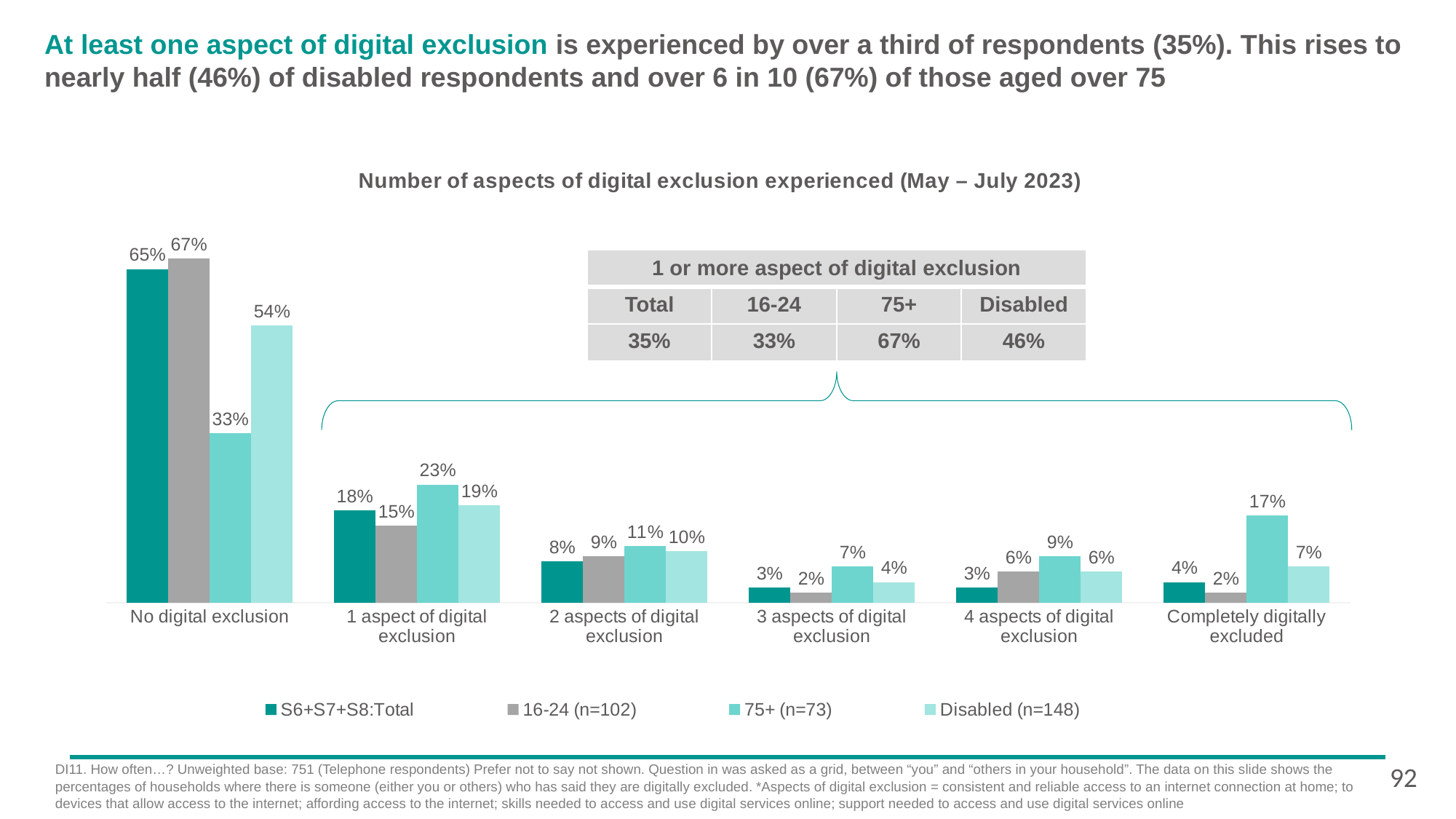
Which series has the lowest value in the '3 aspects of digital exclusion' category? 16-24 (n=102) How many series does the chart legend list? 4 What is the title of the chart? Number of aspects of digital exclusion experienced (May – July 2023) For the S6+S7+S8:Total series, do the values rise or fall from 'No digital exclusion' to '4 aspects of digital exclusion'? Fall What is the difference between the 75+ (n=73) and 16-24 (n=102) values in the 'Completely digitally excluded' category? 15% What is the value for the 75+ (n=73) series in the 'No digital exclusion' category? 33% Which series has the highest value in the 'No digital exclusion' category? 16-24 (n=102) How many categories are shown on the x axis of the chart? 6 What is the value for the S6+S7+S8:Total series in the '1 aspect of digital exclusion' category? 18% In the '2 aspects of digital exclusion' category, which is larger: the 75+ (n=73) value or the Disabled (n=148) value? 75+ (n=73) What is the value for the Disabled (n=148) series in the 'Completely digitally excluded' category? 7% What kind of chart is shown on the slide? Bar chart